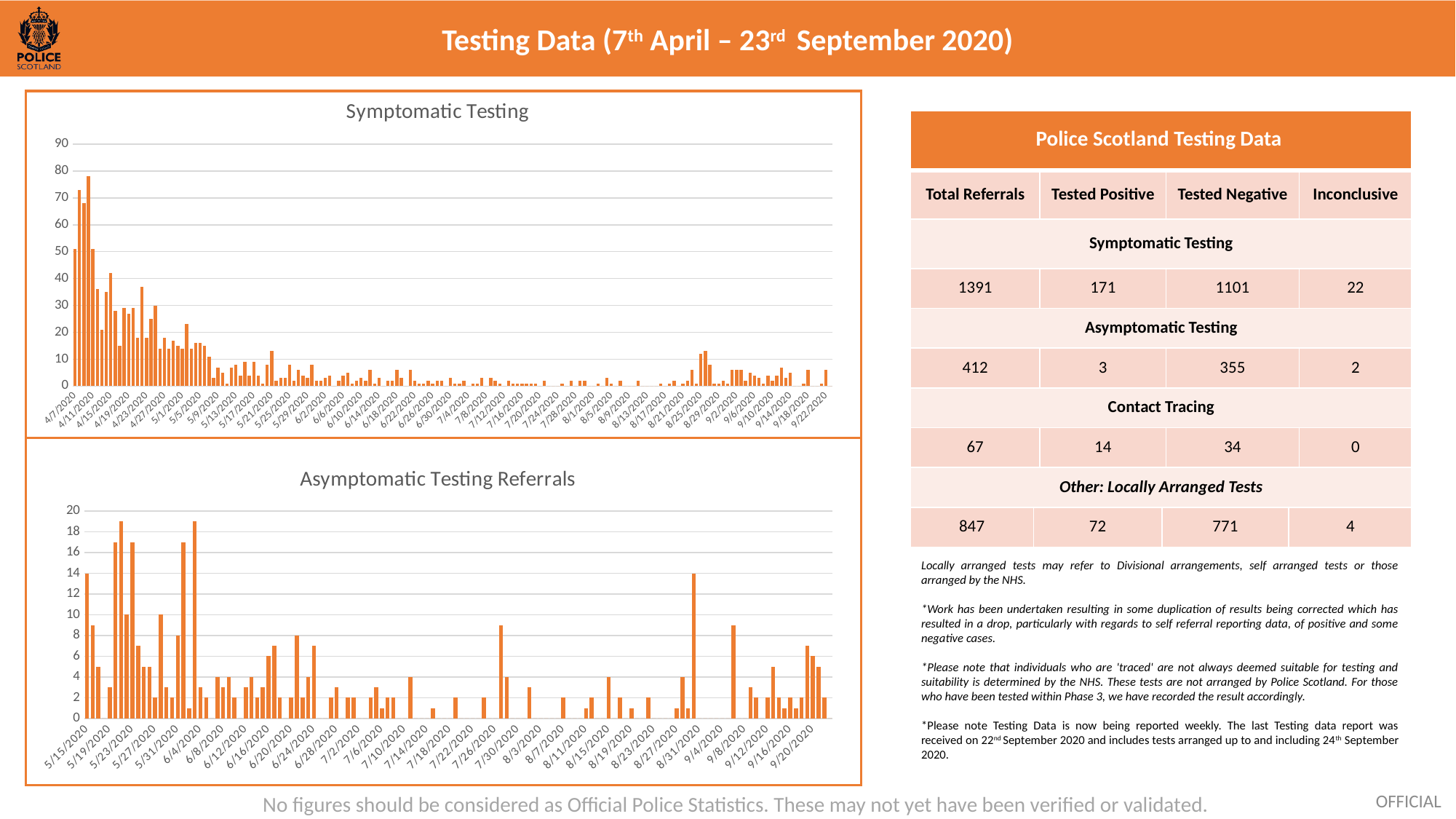
What is the title of the bottom chart on the slide? Asymptomatic Testing Referrals What kind of chart is the Symptomatic Testing chart? bar chart In the Asymptomatic Testing Referrals chart, is the value for 5/15/2020 greater or less than 10? greater What is the title of the top chart on the slide? Symptomatic Testing What kind of chart is the Asymptomatic Testing Referrals chart? bar chart In the Symptomatic Testing chart, do the values generally rise or fall from April to September? fall In the Symptomatic Testing chart, is the value for 4/7/2020 greater or less than 60? less In the Symptomatic Testing chart, is the highest bar greater or less than 70? greater In the Symptomatic Testing chart, is the value for 4/7/2020 larger than the value for 9/22/2020? Yes